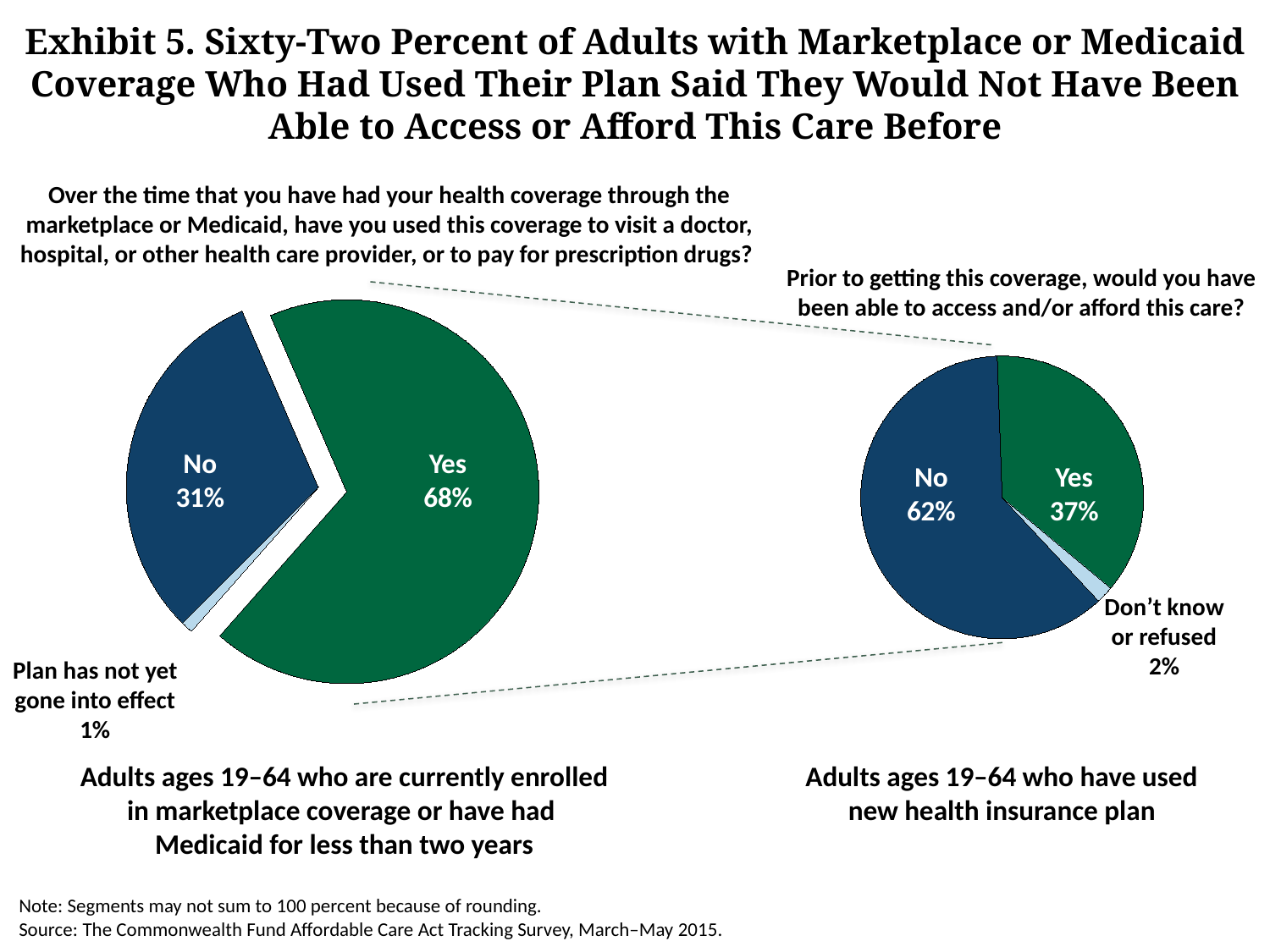
In the right pie chart, which response has the smallest share? Don't know or refused In the left pie chart, what percentage said their plan has not yet gone into effect? 1% In the right pie chart, what percentage answered Yes? 37% In the right pie chart, what is the difference in percentage points between the No and Yes responses? 25 In the left pie chart, which response has the largest share? Yes What type of chart is used on this slide? Pie chart In the left pie chart (about using coverage to visit a doctor or pay for prescriptions), what percentage of adults answered Yes? 68% In the left pie chart, what percentage of adults answered No? 31% In the right pie chart, what percentage answered Don't know or refused? 2% In the left pie chart, is the share for Yes larger or smaller than the share for No? Larger In the right pie chart (about being able to access or afford care before coverage), what percentage answered No? 62% In the left pie chart, how many segments are shown? 3